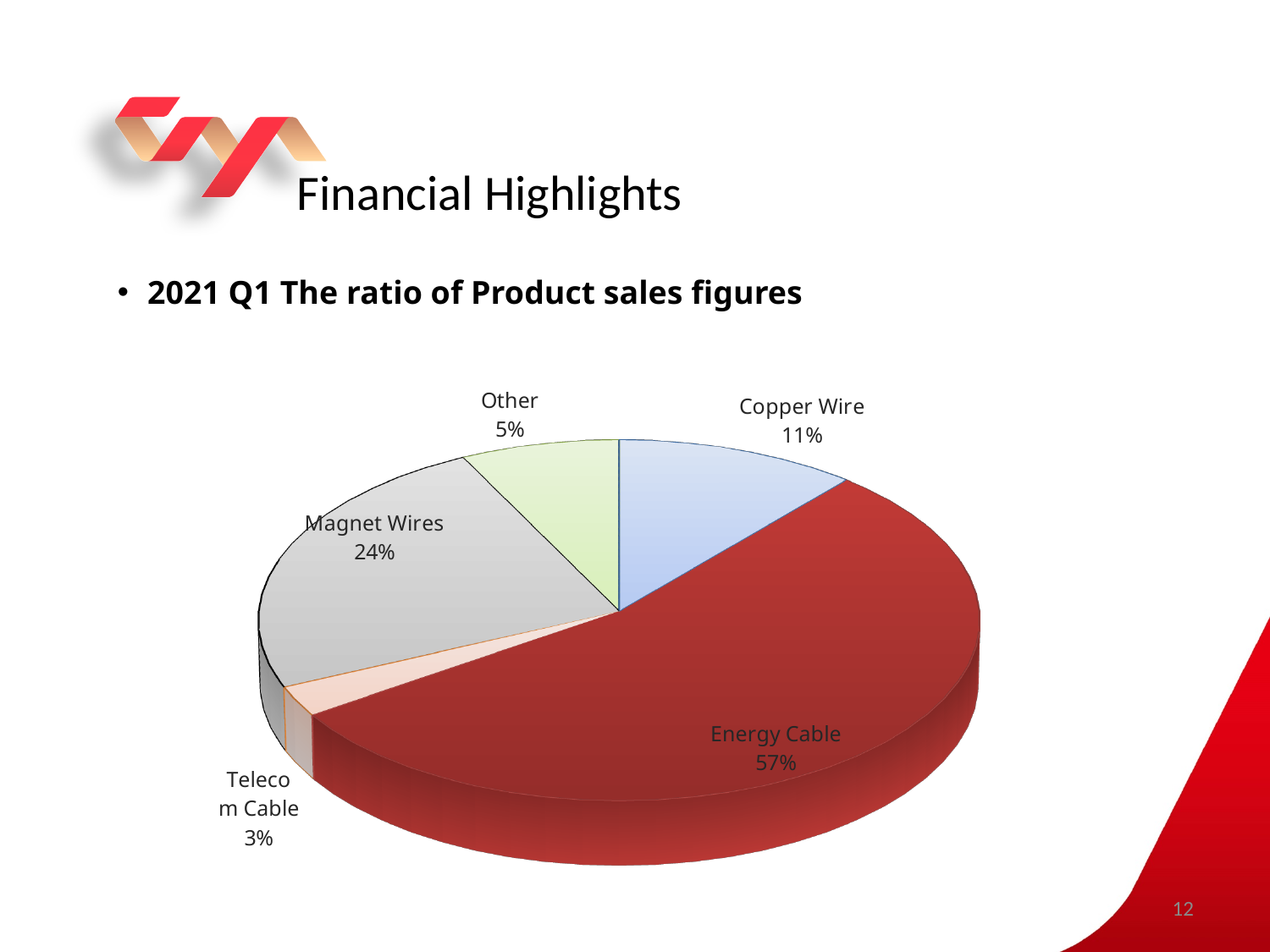
What percentage is shown for Other? 5% Which product category has the smallest share of sales? Telecom Cable How many product categories are shown in the pie chart? 5 What percentage is shown for Magnet Wires? 24% Which has a larger share, Copper Wire or Other? Copper Wire What is the difference in percentage points between Energy Cable and Magnet Wires? 33 What percentage is shown for Telecom Cable? 3% What share of product sales does Energy Cable account for? 57% What kind of chart is shown on the slide? Pie chart What period does the chart's data refer to, according to the slide text? 2021 Q1 What percentage is shown for Copper Wire? 11% Which product category has the largest share of sales? Energy Cable